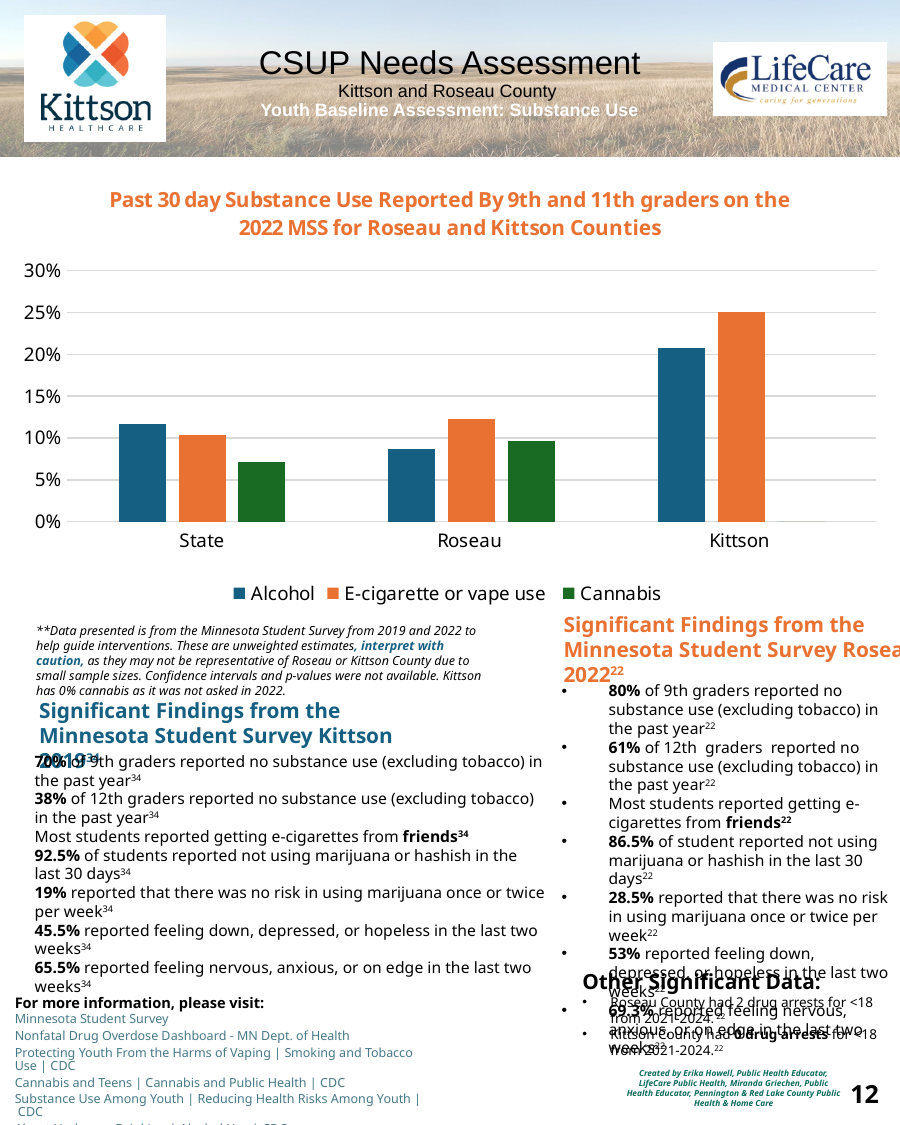
Which category has the highest value for Alcohol? Kittson Which colour represents Cannabis in the chart legend? green What type of chart is shown on the slide? bar chart How many series does the chart legend list? 3 Which category has the highest value for E-cigarette or vape use? Kittson How many categories are shown on the x axis of the chart? 3 Is the value for E-cigarette or vape use in Kittson greater or less than 20%? greater Is the value for Alcohol in Kittson greater or less than 15%? greater In State, which is larger: Alcohol or Cannabis? Alcohol Is the value for Cannabis in State greater or less than 10%? less In Kittson, which is larger: Alcohol or E-cigarette or vape use? E-cigarette or vape use